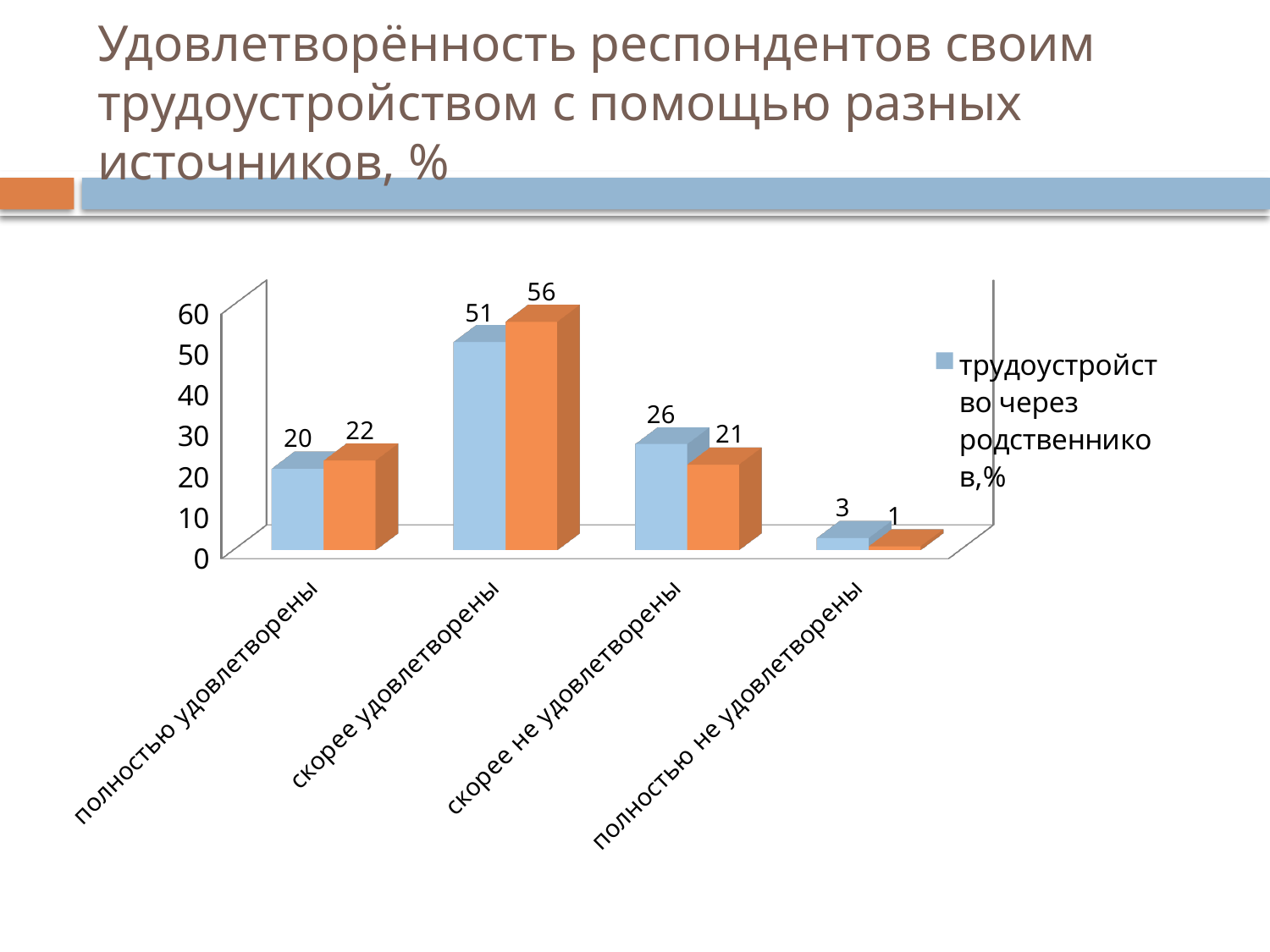
What is the difference between the orange series and "трудоустройство через родственников" in the category "скорее удовлетворены"? 5 What is the value of the orange series in the category "полностью удовлетворены"? 22 What is the value for "трудоустройство через родственников" in the category "скорее удовлетворены"? 51 Which category has the lowest value in the orange series? полностью не удовлетворены What is the value for "трудоустройство через родственников" in the category "полностью не удовлетворены"? 3 What is the value of the orange series in the category "скорее удовлетворены"? 56 How many categories are shown on the x axis of the chart? 4 In the category "скорее не удовлетворены", which is larger: the value for "трудоустройство через родственников" or the orange series? трудоустройство через родственников Which category has the highest value for "трудоустройство через родственников"? скорее удовлетворены What is the title of the slide containing the chart? Удовлетворённость респондентов своим трудоустройством с помощью разных источников, % What kind of chart is shown on the slide? bar chart Is the value for "трудоустройство через родственников" in the category "скорее не удовлетворены" greater or less than 20? greater